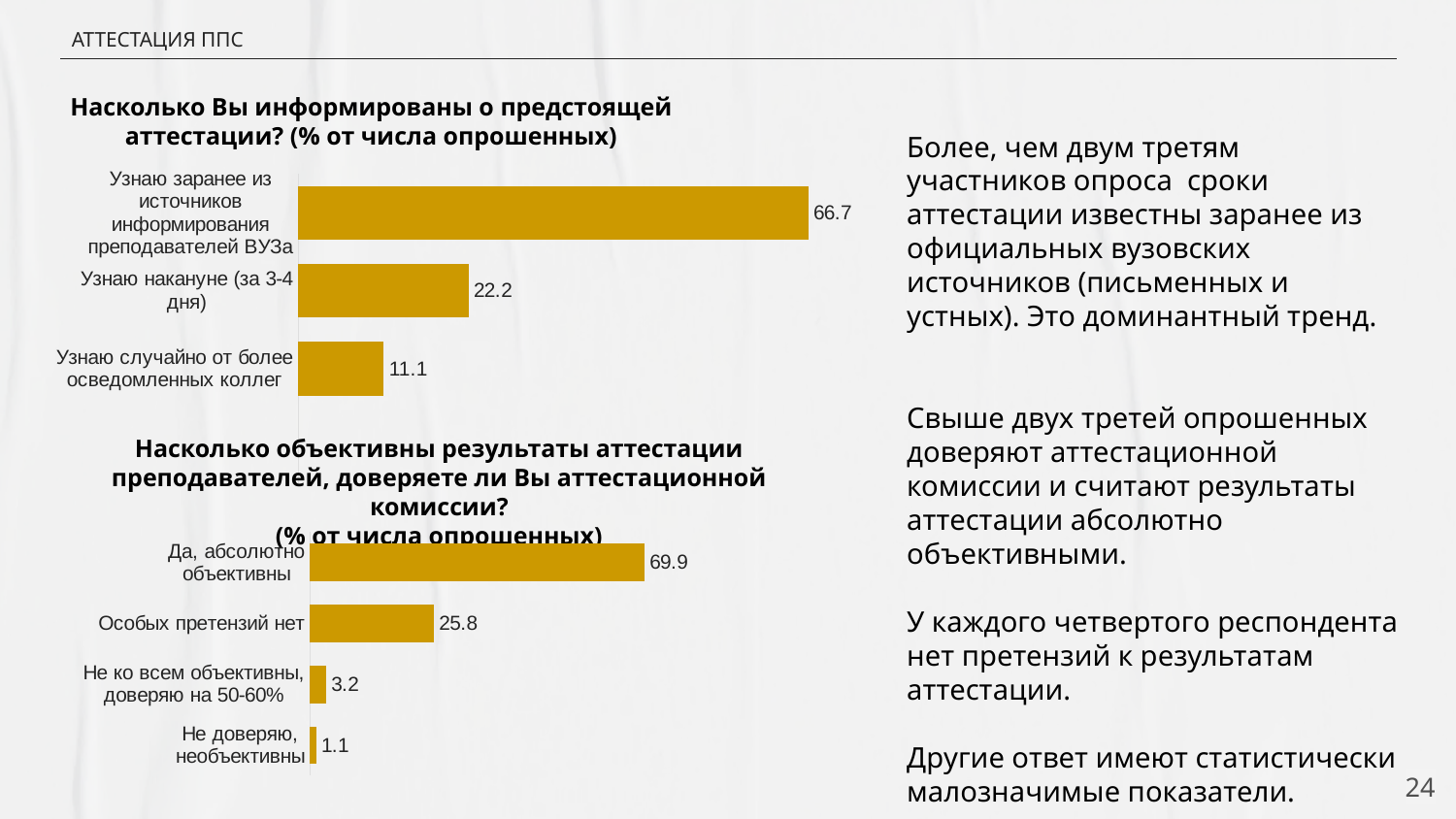
How many categories are shown in the top chart? 3 In the bottom chart, which is larger: "Не ко всем объективны, доверяю на 50-60%" or "Не доверяю, необъективны"? Не ко всем объективны, доверяю на 50-60% How many categories are shown in the bottom chart? 4 In the bottom chart, which category has the highest value? Да, абсолютно объективны In the bottom chart ("Насколько объективны результаты аттестации преподавателей..."), what is the value for "Да, абсолютно объективны"? 69.9 In the bottom chart, what is the difference between "Особых претензий нет" and "Не ко всем объективны, доверяю на 50-60%"? 22.6 In the bottom chart, what is the value for "Особых претензий нет"? 25.8 In the top chart, which category has the lowest value? Узнаю случайно от более осведомленных коллег In the top chart ("Насколько Вы информированы о предстоящей аттестации?"), what is the value for "Узнаю заранее из источников информирования преподавателей ВУЗа"? 66.7 In the top chart, what is the difference between "Узнаю заранее из источников информирования преподавателей ВУЗа" and "Узнаю накануне (за 3-4 дня)"? 44.5 In the top chart, what is the value for "Узнаю накануне (за 3-4 дня)"? 22.2 What type of chart is the top chart? Bar chart